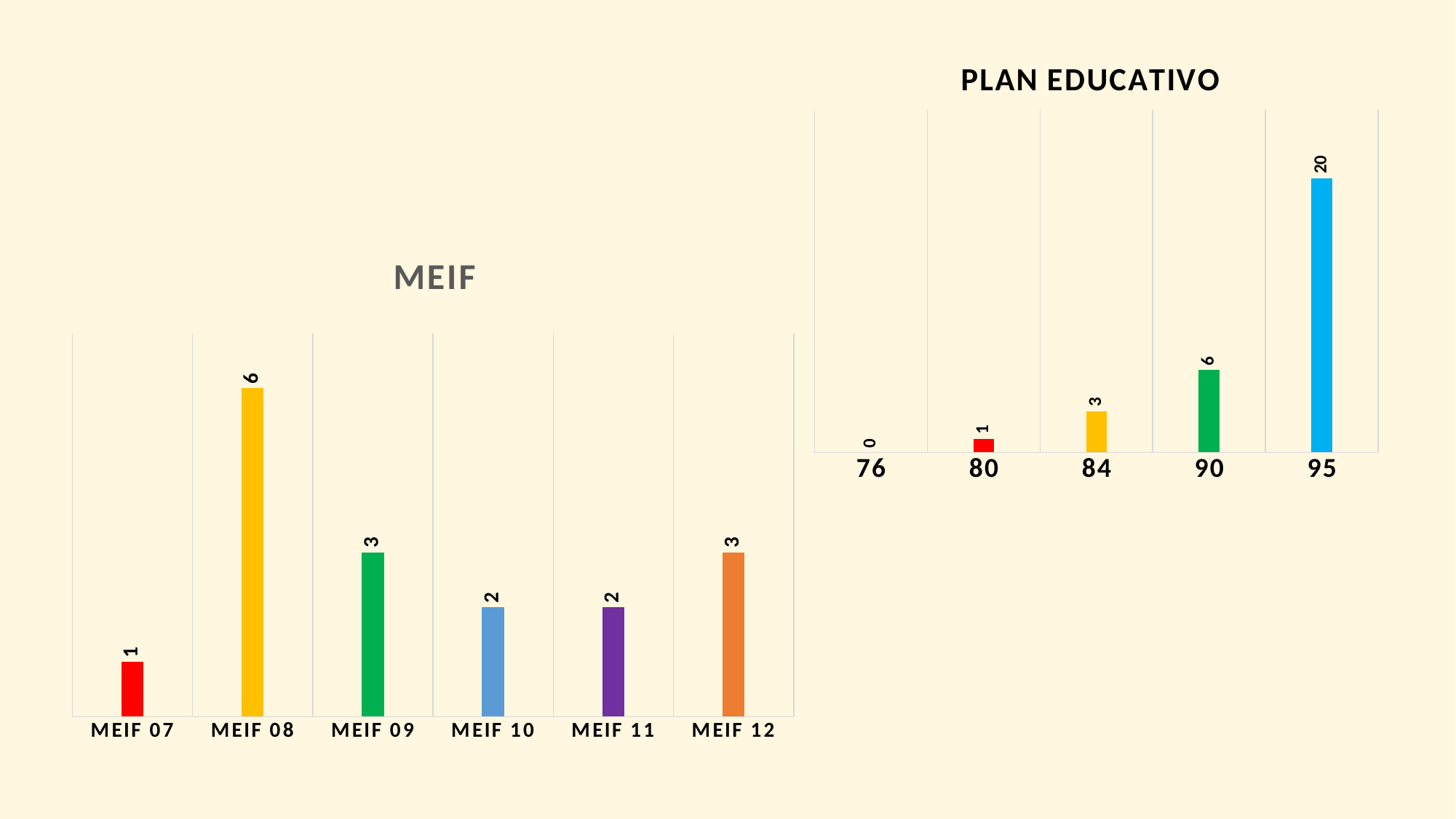
In the MEIF chart, what is the value for MEIF 08? 6 In the MEIF chart, which category has the highest value? MEIF 08 In the PLAN EDUCATIVO chart, do the values rise or fall from left to right along the x axis? rise In the PLAN EDUCATIVO chart, what is the difference between the values for 95 and 90? 14 In the PLAN EDUCATIVO chart, which category has the lowest value? 76 In the MEIF chart, how many categories are shown on the x axis? 6 In the MEIF chart, what is the difference between the values for MEIF 08 and MEIF 09? 3 What kind of chart is the PLAN EDUCATIVO chart? bar chart In the PLAN EDUCATIVO chart, which is larger, the value for 84 or the value for 90? 90 In the MEIF chart, what is the value for MEIF 10? 2 In the MEIF chart, which category has the lowest value? MEIF 07 In the PLAN EDUCATIVO chart, what is the value for 95? 20